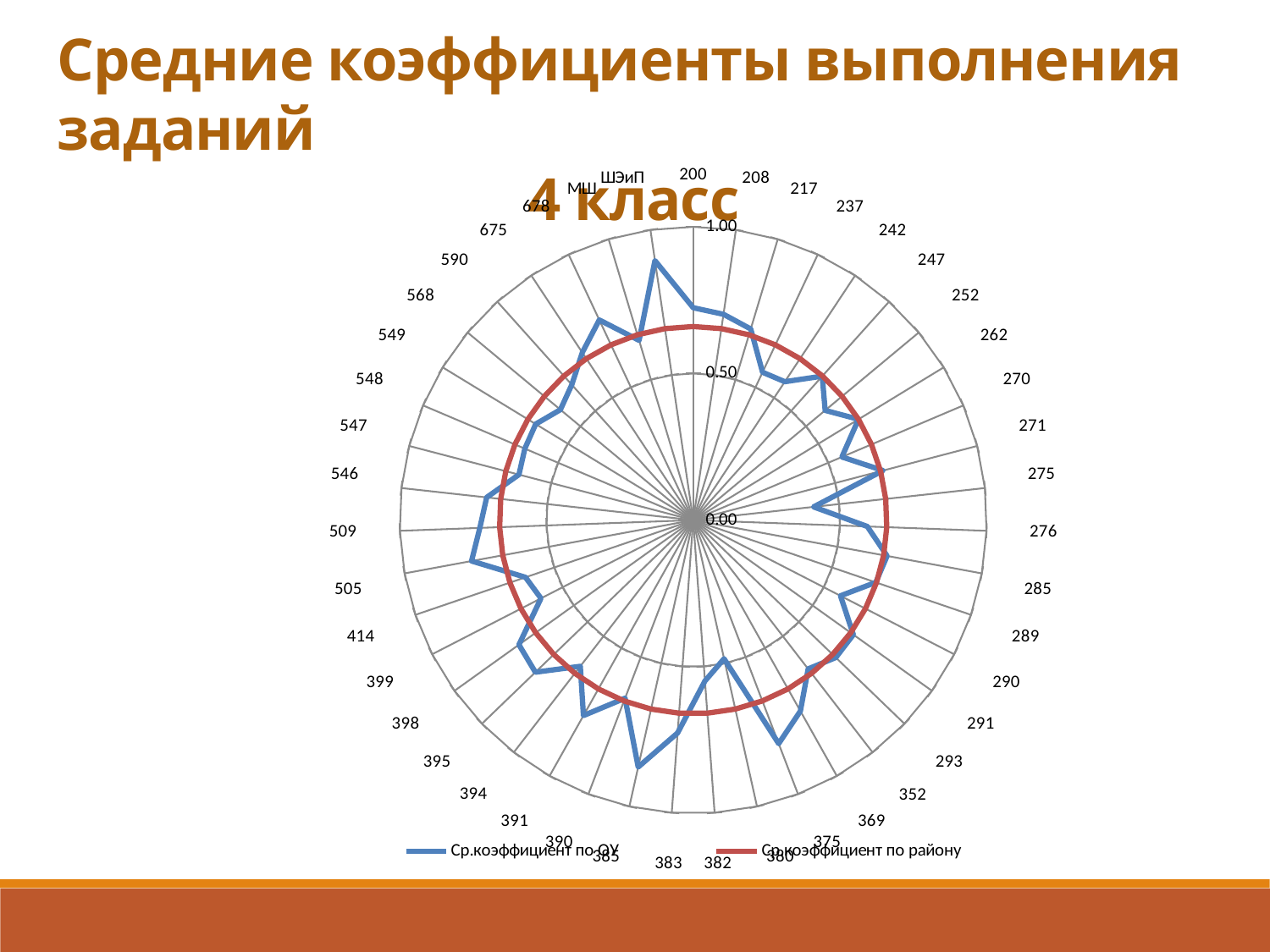
For category 200, which series has the larger value, Ср.коэффициент по ОУ or Ср.коэффициент по району? Ср.коэффициент по ОУ Is the value of Ср.коэффициент по району for 200 greater or less than 1.00? less What kind of chart is shown on the slide? radar chart Which series is drawn in red according to the legend? Ср.коэффициент по району Is the value of Ср.коэффициент по ОУ for 546 greater or less than 0.50? greater Is the value of Ср.коэффициент по району for 276 greater or less than 0.50? greater What is the title of the chart? 4 класс What is the highest value shown on the chart's radial axis? 1.00 For category 380, which series has the larger value, Ср.коэффициент по ОУ or Ср.коэффициент по району? Ср.коэффициент по району How many series does the legend list? 2